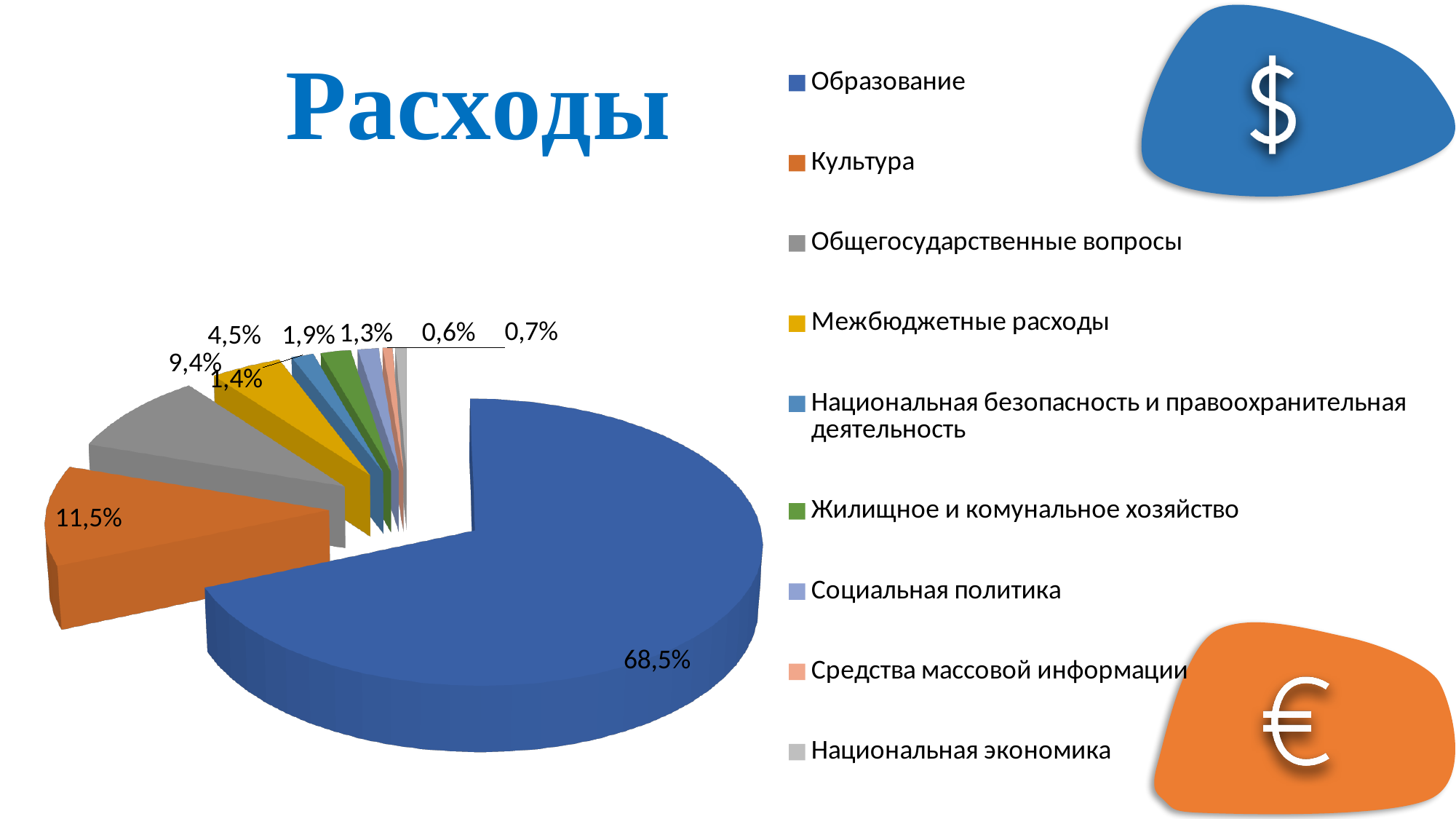
What is the value for Культура? 11,5% Which category has the largest slice of the pie? Образование Which is larger, the slice for Культура or the slice for Межбюджетные расходы? Культура What is the smallest percentage labelled on the pie? 0,6% How many categories does the chart's legend list? 9 What is the value for Общегосударственные вопросы? 9,4% What is the difference between the values for Культура and Общегосударственные вопросы? 2,1% What is the title of the slide's chart? Расходы What type of chart is shown on the slide? pie chart Which colour represents Образование in the chart? blue What share of the pie does Образование take? 68,5% What is the value for Межбюджетные расходы? 4,5%